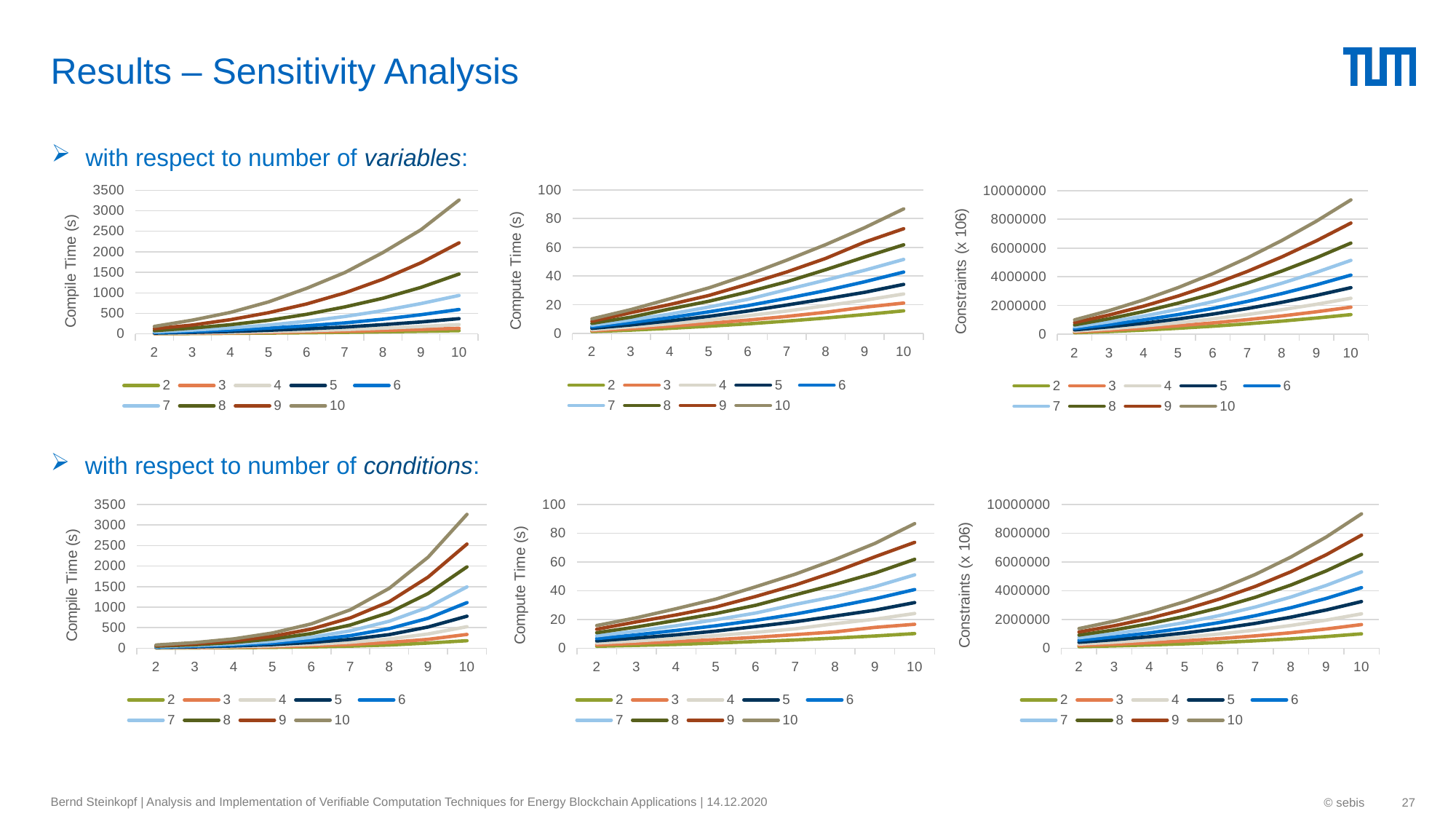
In the bottom-middle chart (Compute Time, conditions), is the value of series 2 at x = 10 greater or less than 20? less What kind of chart is the top-left chart (Compile Time with respect to number of variables)? line chart What is the y-axis label of the top-right chart? Constraints (x 106) In the top-left chart (Compile Time, variables), which series is highest at x = 10? 10 In the bottom-middle chart (Compute Time, conditions), which series is lowest at x = 10? 2 How many series does the legend of the top-left chart (Compile Time, variables) list? 9 How many points are on the x axis of the top-middle chart (Compute Time, variables)? 9 In the top-left chart (Compile Time, variables), do the values of series 10 rise or fall as the x axis goes from 2 to 10? rise In the top-middle chart (Compute Time, variables), is the value of series 10 at x = 10 greater or less than 80? greater In the top-left chart (Compile Time, variables), is the value of series 10 at x = 10 greater or less than 3000? greater In the bottom-left chart (Compile Time, conditions), which is larger at x = 10: series 9 or series 8? 9